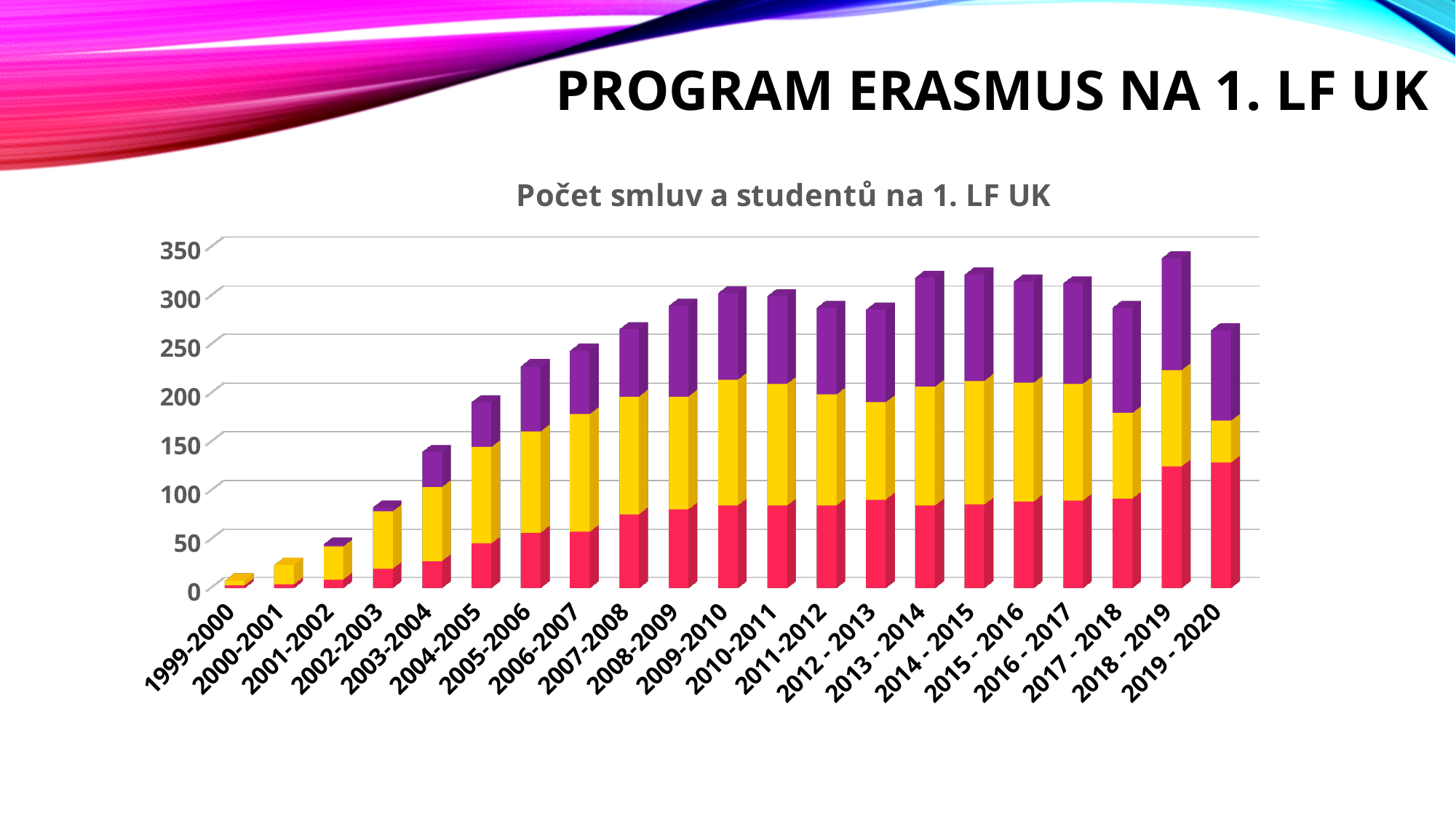
What kind of chart is shown on the slide? Stacked bar chart Which academic year has the shortest stacked bar? 1999-2000 What is the title of the chart? Počet smluv a studentů na 1. LF UK Is the total for 2002-2003 greater or less than 100? less How many differently coloured segments make up each stacked bar? 3 Is the total for 2018 - 2019 greater or less than 300? greater Is the total for 2004-2005 greater or less than 150? greater Which academic year has the tallest stacked bar? 2018 - 2019 Do the bar totals rise or fall from 1999-2000 to 2005-2006? rise Which has the larger total, 2018 - 2019 or 2019 - 2020? 2018 - 2019 How many academic years (categories) are shown on the x axis? 21